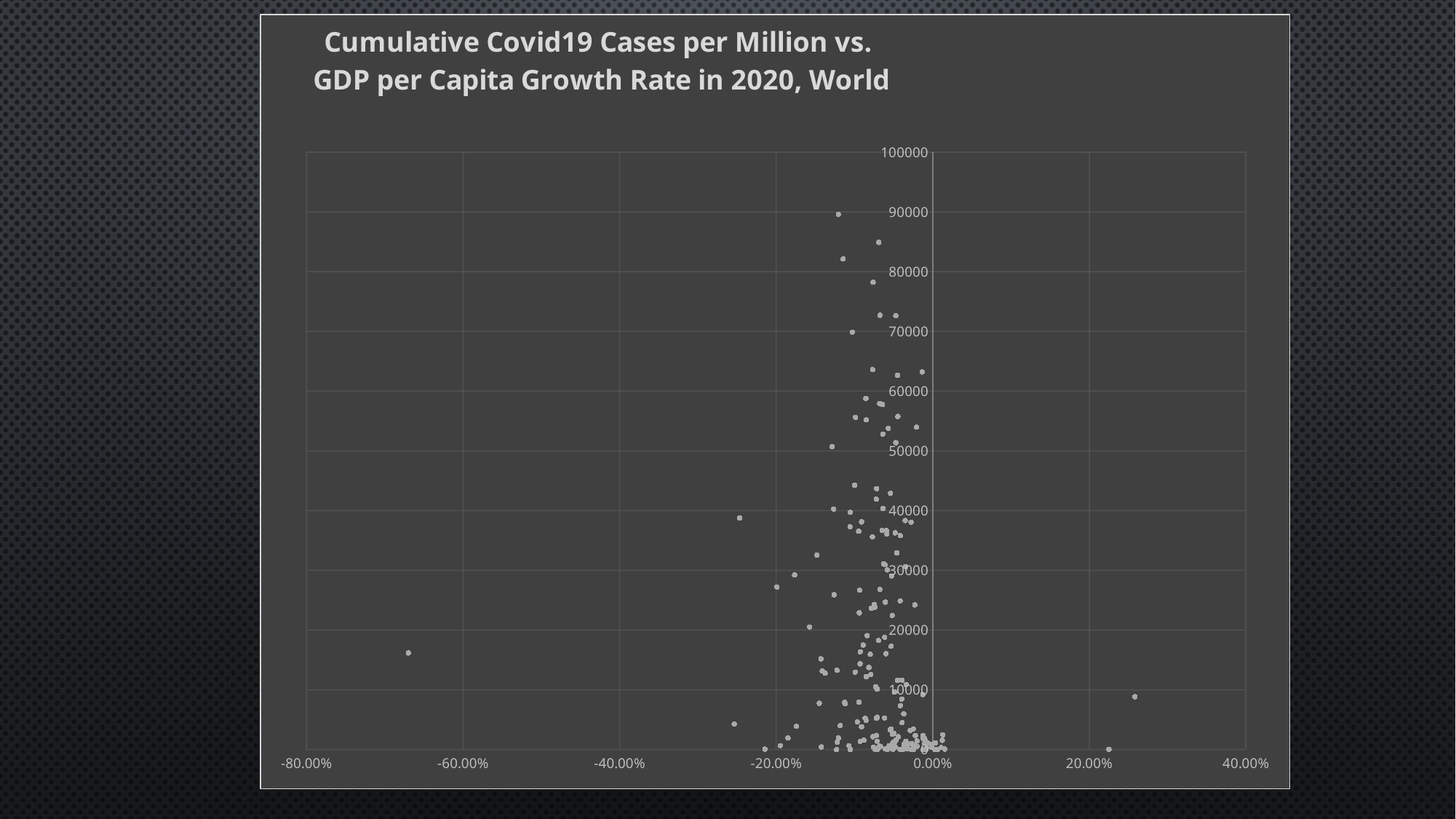
What is the highest value labelled on the horizontal axis? 40.00% Is the horizontal-axis value of the rightmost point greater or less than 20.00%? greater Is the horizontal-axis value of the leftmost point greater or less than -60.00%? less What is the title of the chart? Cumulative Covid19 Cases per Million vs. GDP per Capita Growth Rate in 2020, World Do any points lie above the 100000 gridline on the vertical axis? No What is the highest value labelled on the vertical axis? 100000 Between which two horizontal-axis tick labels are most of the points clustered? -20.00% and 0.00% What is the lowest value labelled on the horizontal axis? -80.00% What kind of chart is shown on the slide? scatter plot How many tick labels are shown on the horizontal axis? 7